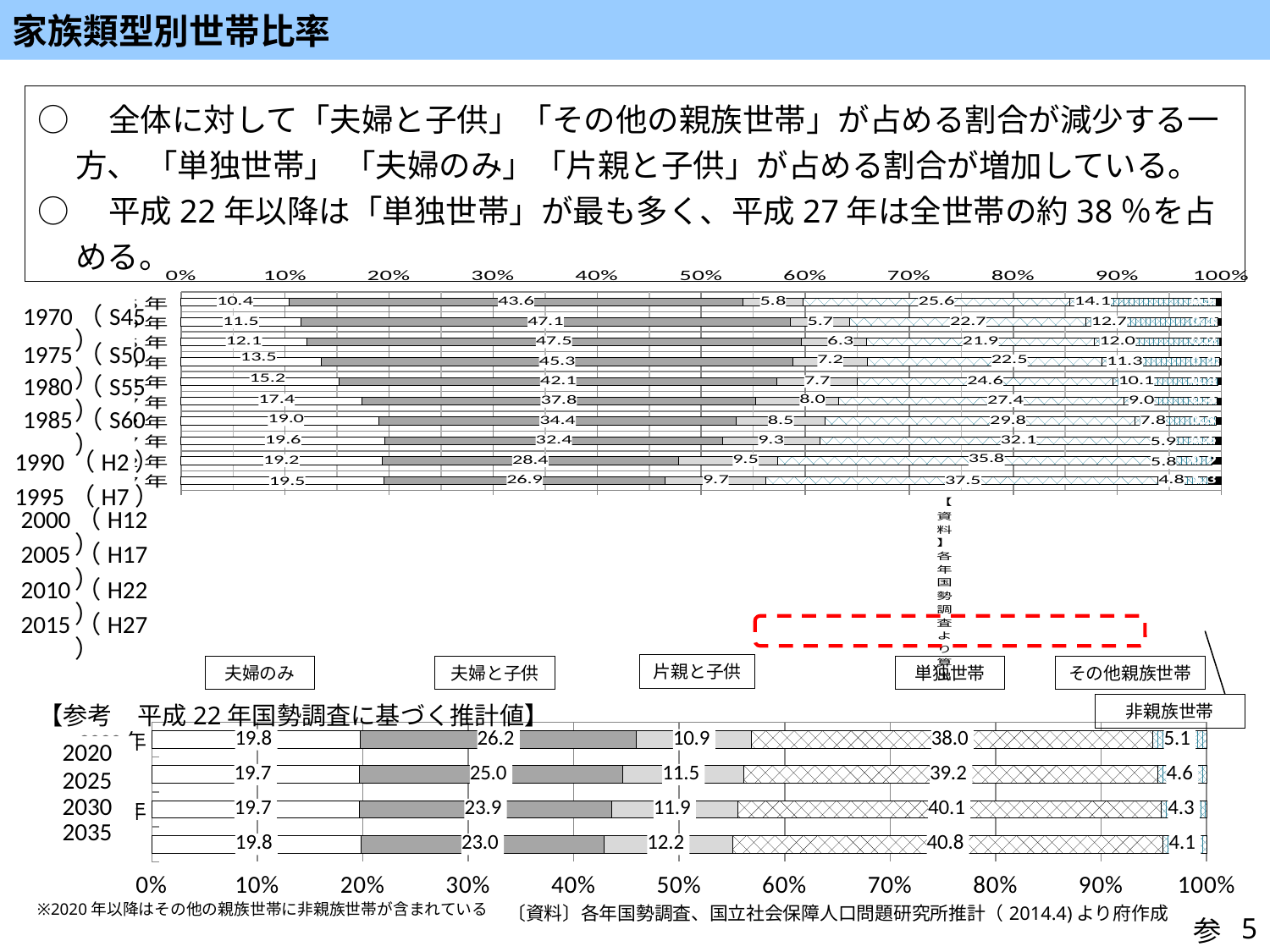
In the top chart, what is the difference between the 単独世帯 values for 2015 (H27) and 1970 (S45)? 11.9 In the top chart, how many years (bars) are plotted? 10 In the top chart, does the value for 夫婦と子供 rise or fall from 1980 (S55) to 2015 (H27)? fall What type of chart is the bottom chart (平成22年国勢調査に基づく推計値)? stacked bar chart In the top chart, which year has the lowest value for その他親族世帯? 2015 (H27) In the top chart, which year has the highest value for 夫婦と子供? 1980 (S55) In the top chart, what is the value for 単独世帯 in 2015 (H27)? 37.5 In the top chart, what is the value for 夫婦のみ in 2000 (H12)? 19.0 In the top chart, what is the value for 夫婦と子供 in 1970 (S45)? 43.6 In the bottom chart (平成22年国勢調査に基づく推計値), what is the value for 単独世帯 in 2035? 40.8 In the bottom chart (平成22年国勢調査に基づく推計値), what is the difference between the 片親と子供 values for 2035 and 2020? 1.3 In the bottom chart (平成22年国勢調査に基づく推計値), which is larger in 2020: 夫婦と子供 or 単独世帯? 単独世帯